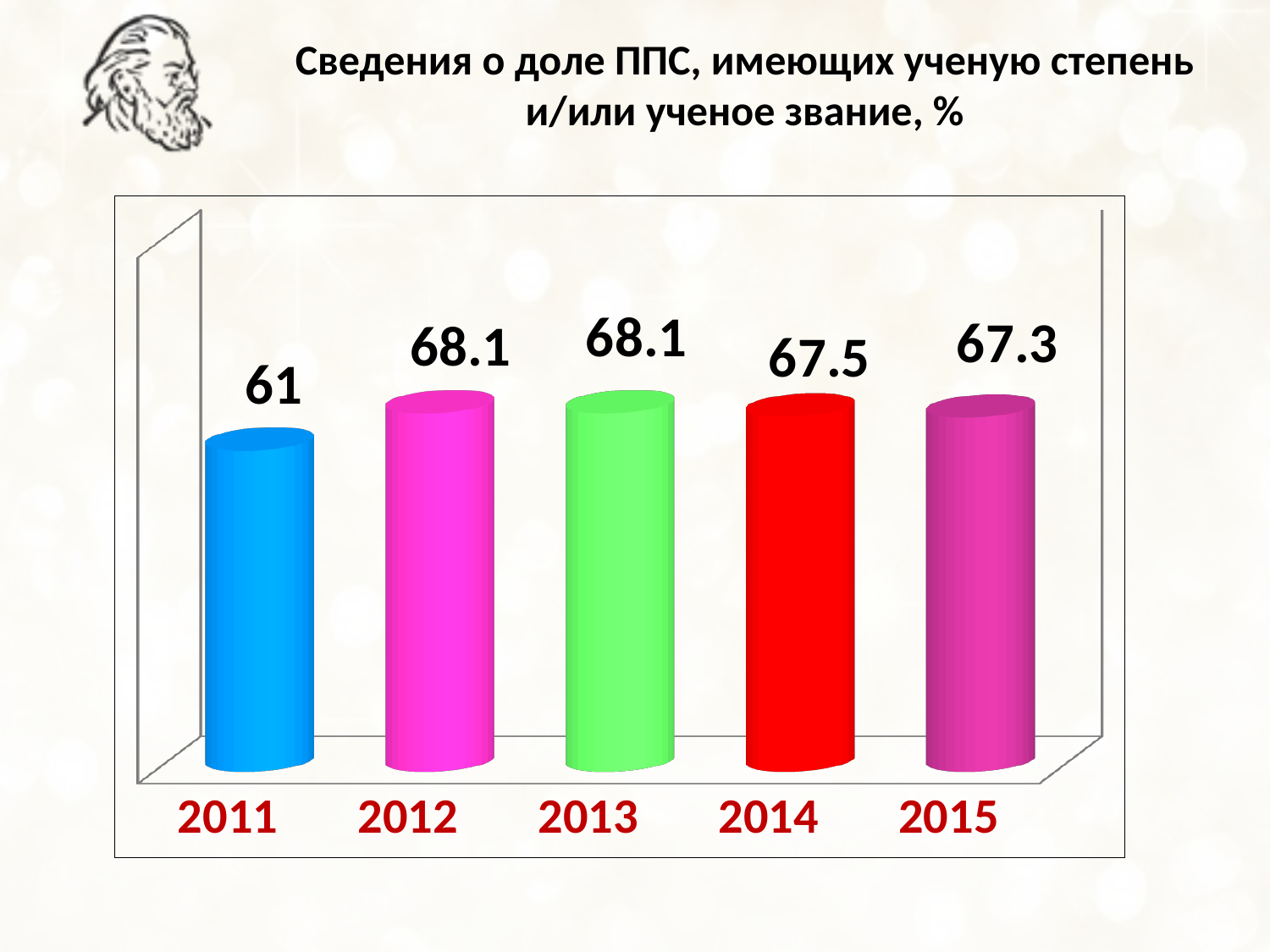
What is the value for 2011? 61 What is the difference between the values for 2012 and 2011? 7.1 Which year has the lowest value? 2011 Which is larger, the value for 2013 or the value for 2015? 2013 How many years are shown on the chart? 5 What is the difference between the values for 2014 and 2015? 0.2 Do the values rise or fall from 2013 to 2015? fall What is the value for 2014? 67.5 What is the value for 2015? 67.3 What colour is the bar for 2011? blue What is the value for 2012? 68.1 What kind of chart is shown on the slide? bar chart